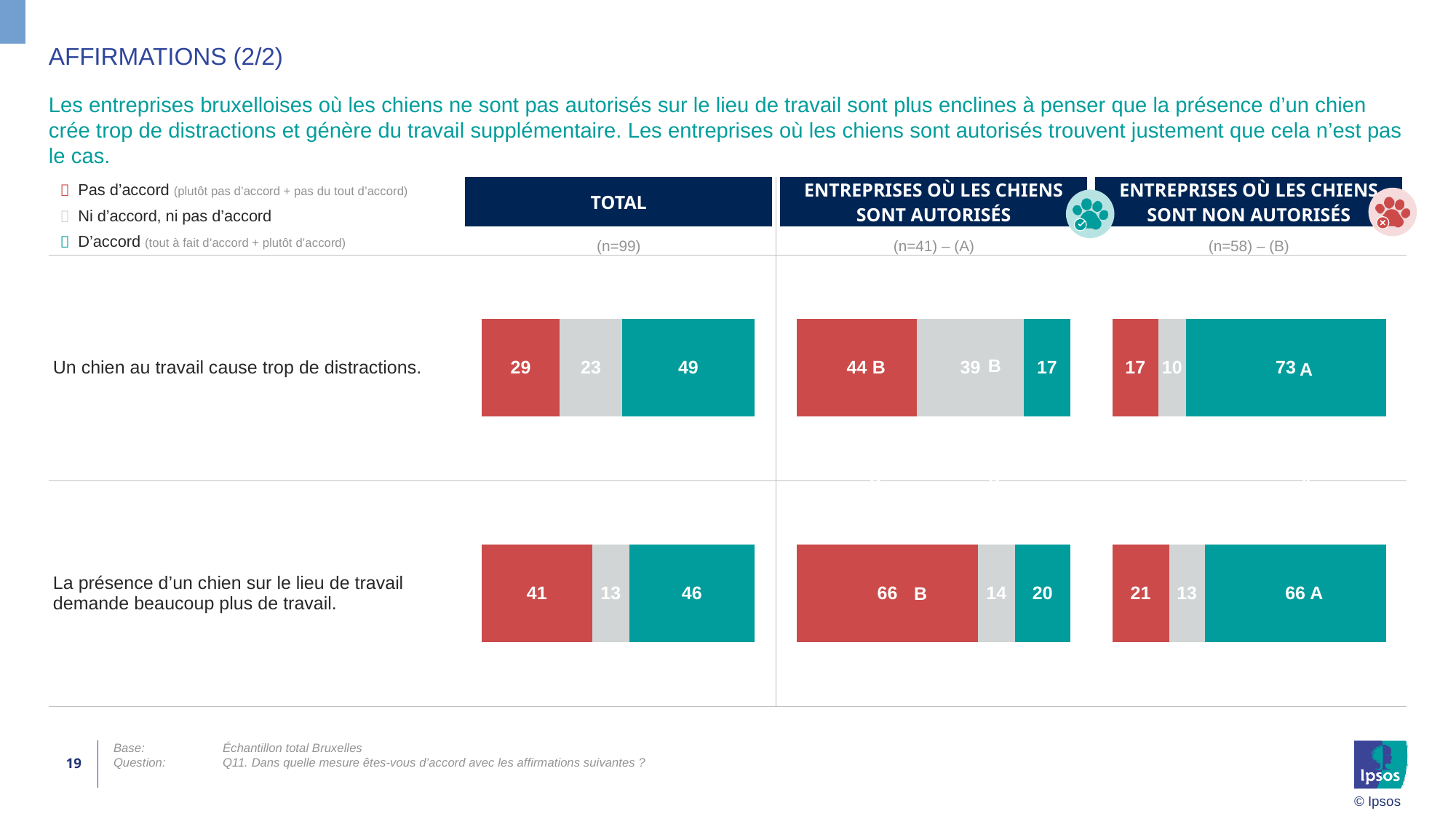
In the 'Entreprises où les chiens sont autorisés' chart, which segment is smallest for 'Un chien au travail cause trop de distractions.'? D'accord In the 'Entreprises où les chiens sont non autorisés' chart, which segment is largest for 'La présence d'un chien sur le lieu de travail demande beaucoup plus de travail.'? D'accord What kind of chart is used on the slide? Stacked bar chart How many statements (rows) are plotted on the slide? 2 In the TOTAL chart, what is the 'D'accord' value for 'Un chien au travail cause trop de distractions.'? 49 In the TOTAL chart, what is the 'Pas d'accord' value for 'La présence d'un chien sur le lieu de travail demande beaucoup plus de travail.'? 41 In the 'Entreprises où les chiens sont autorisés' chart, what is the 'Ni d'accord, ni pas d'accord' value for 'La présence d'un chien sur le lieu de travail demande beaucoup plus de travail.'? 14 What is the difference between the 'D'accord' values for 'Un chien au travail cause trop de distractions.' in the 'non autorisés' chart (73) and the 'autorisés' chart (17)? 56 For 'La présence d'un chien sur le lieu de travail demande beaucoup plus de travail.', is the 'Pas d'accord' value larger in the 'autorisés' chart or the 'non autorisés' chart? Entreprises où les chiens sont autorisés In the 'Entreprises où les chiens sont non autorisés' chart, what is the 'D'accord' value for 'Un chien au travail cause trop de distractions.'? 73 How many response categories does the legend list? 3 In the 'Entreprises où les chiens sont autorisés' chart, what is the 'Pas d'accord' value for 'Un chien au travail cause trop de distractions.'? 44